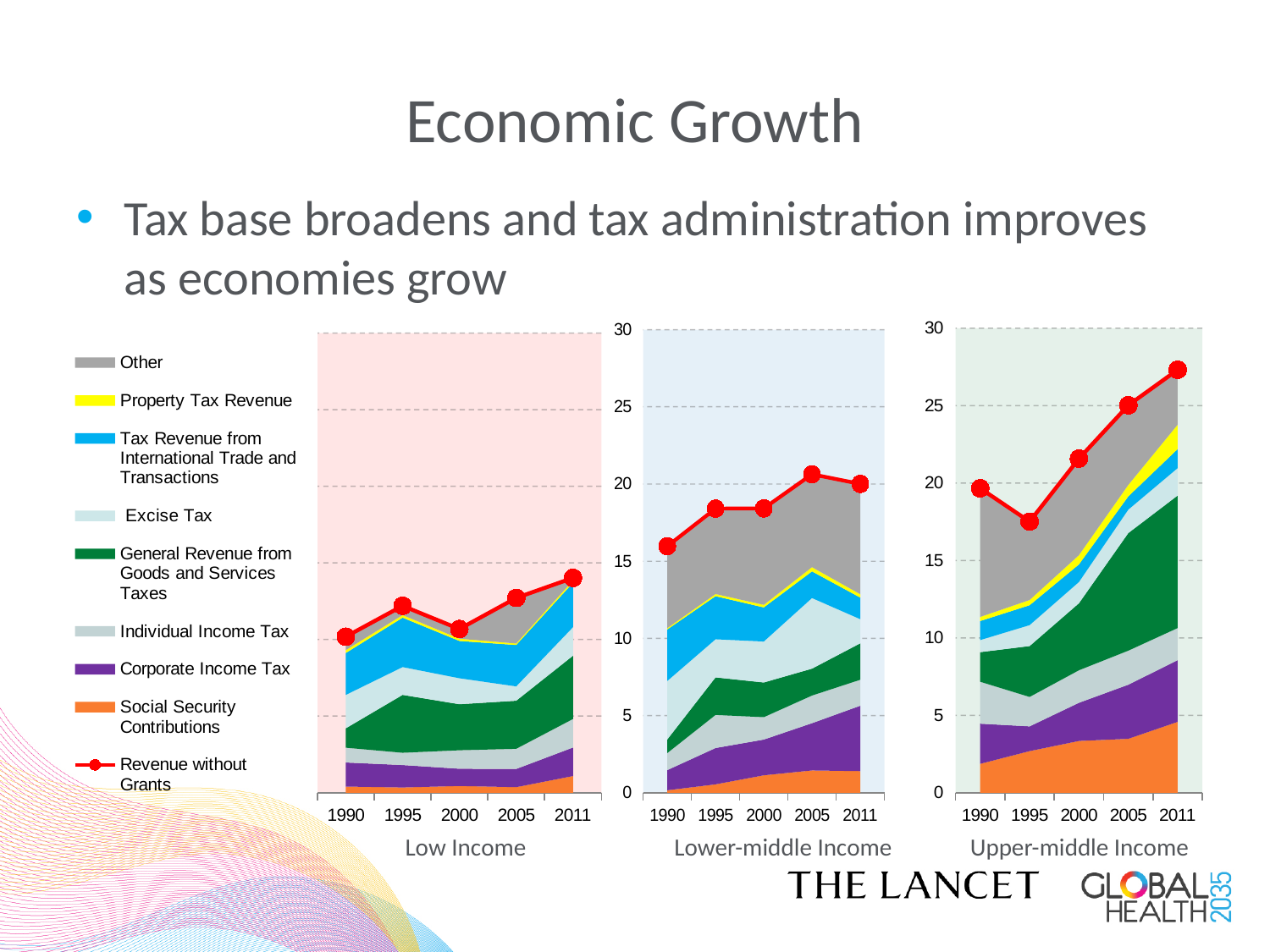
Which colour represents Social Security Contributions in the legend? Orange In the Upper-middle Income chart, does Revenue without Grants rise or fall from 1995 to 2011? rise How many entries does the legend list? 9 What kind of chart is the Upper-middle Income chart? Stacked area chart with a line In the Upper-middle Income chart, which year has the highest Revenue without Grants? 2011 How many years are plotted along the x axis of the Low Income chart? 5 In the Upper-middle Income chart, is the Revenue without Grants value for 2011 greater or less than 25? greater In the Low Income chart, which year has the highest Revenue without Grants? 2011 How many charts are shown on the slide? 3 In the Low Income chart, is the Revenue without Grants value for 1990 greater or less than 15? less In the Upper-middle Income chart, which year has the lowest Revenue without Grants? 1995 In the Lower-middle Income chart, which year has the lowest Revenue without Grants? 1990